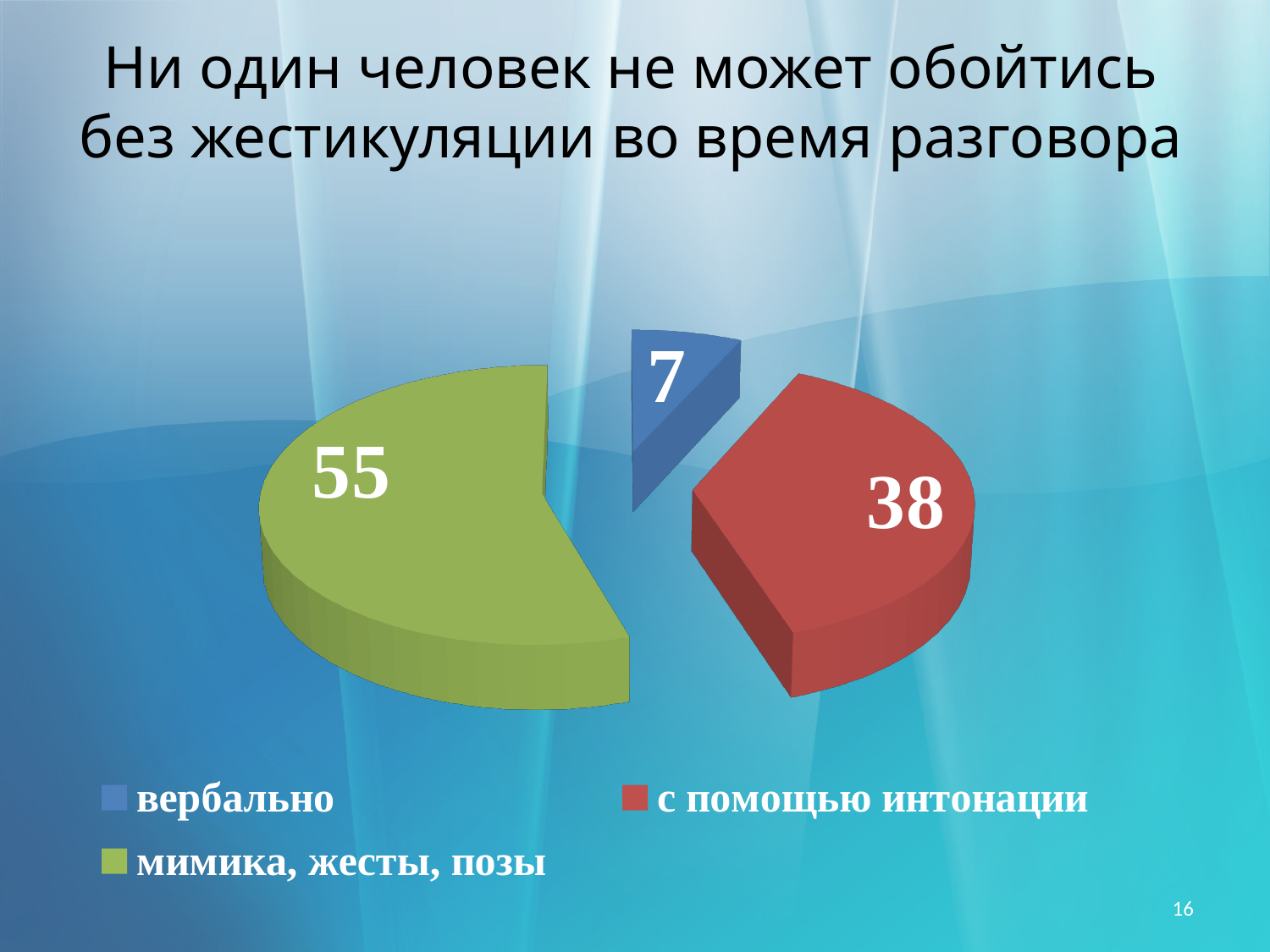
What is the value for "вербально"? 7 What is the difference between the values for "с помощью интонации" and "вербально"? 31 What is the value for "с помощью интонации"? 38 What is the difference between the values for "мимика, жесты, позы" and "с помощью интонации"? 17 What is the value for "мимика, жесты, позы"? 55 Which category has the largest slice? мимика, жесты, позы Which is larger: the value for "с помощью интонации" or the value for "вербально"? с помощью интонации What colour is the slice for "с помощью интонации"? red How many entries does the legend list? 3 How many slices does the pie chart have? 3 Which category has the smallest slice? вербально What kind of chart is shown on the slide? pie chart